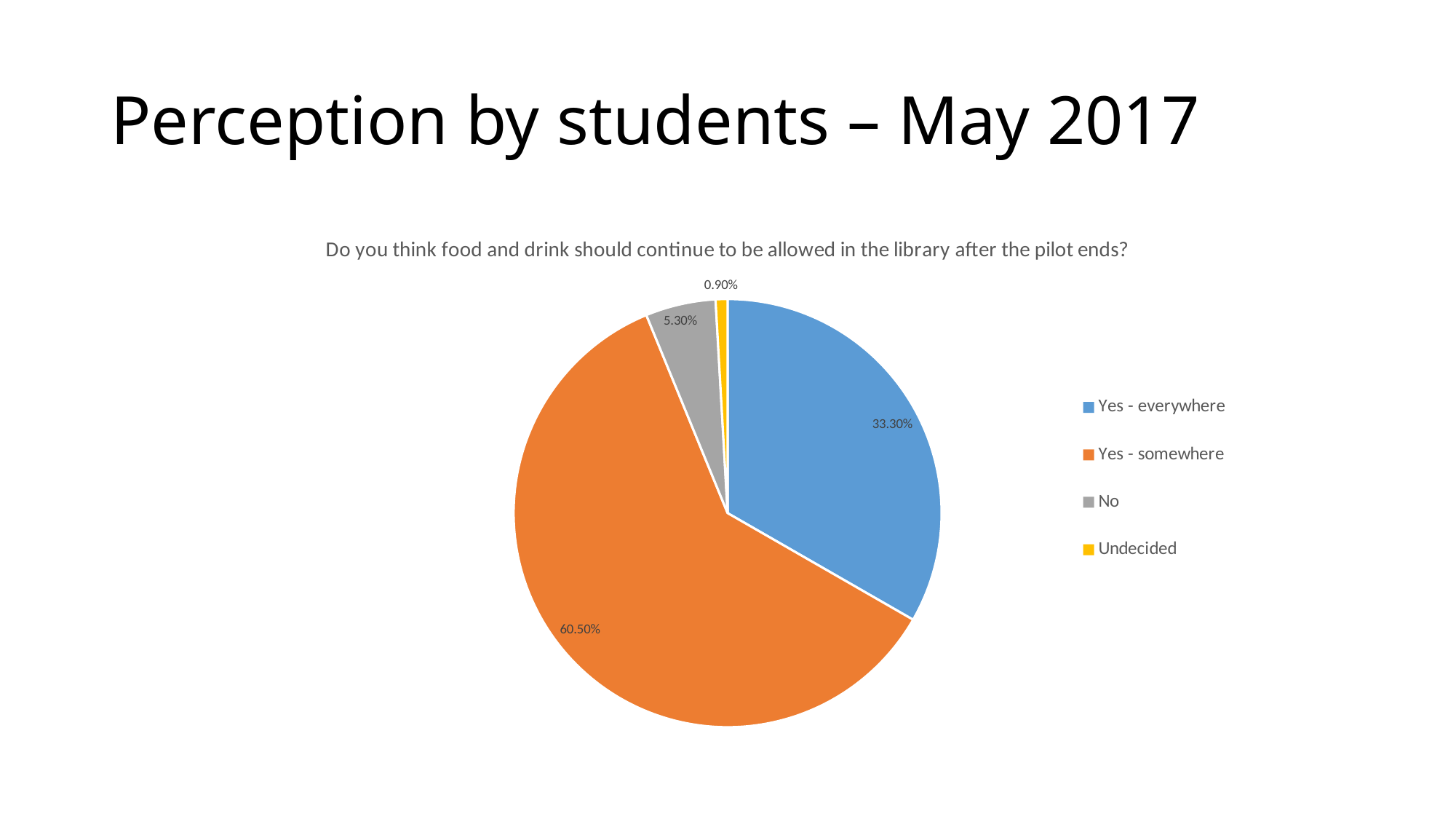
What colour represents the "No" category? grey Which response has the largest share of the pie? Yes - somewhere What is the title of the chart? Do you think food and drink should continue to be allowed in the library after the pilot ends? What share of students answered "No"? 5.30% Which is larger, the share for "No" or the share for "Undecided"? No What share of students answered "Yes - somewhere"? 60.50% Which response has the smallest share of the pie? Undecided What share of students answered "Yes - everywhere"? 33.30% What kind of chart is shown on the slide? pie chart What is the difference in percentage points between "Yes - somewhere" and "Yes - everywhere"? 27.20% What share of students answered "Undecided"? 0.90% How many categories does the legend list? 4